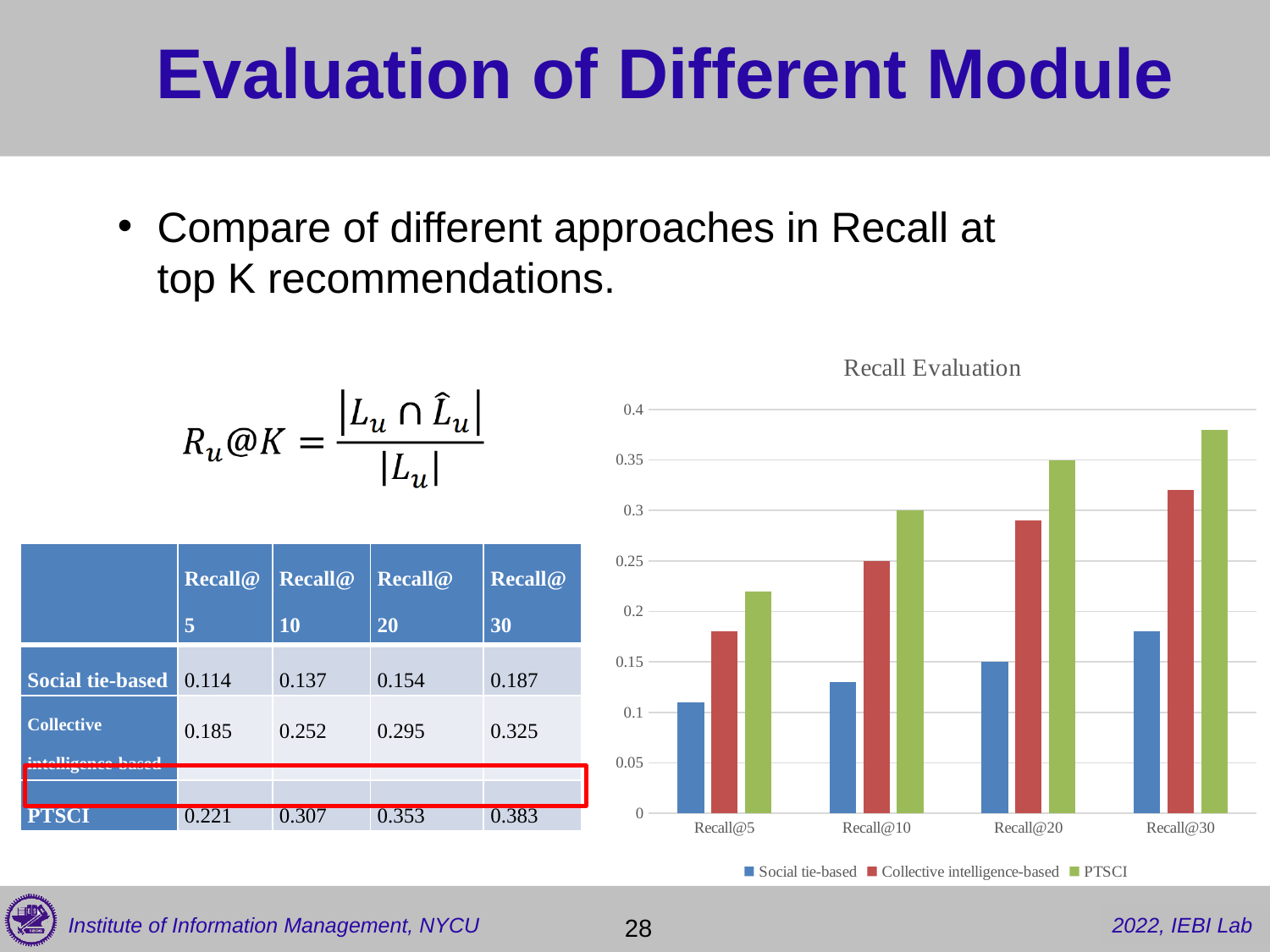
Is the value for Collective intelligence-based at Recall@30 greater or less than 0.3? greater What is the title of the chart? Recall Evaluation Which series has the highest bar in the chart? PTSCI Which series has the lowest bar in the chart? Social tie-based Is the value for Social tie-based at Recall@30 greater or less than 0.2? less What type of chart is shown on the slide? bar chart At Recall@20, which is larger: PTSCI or Social tie-based? PTSCI Do the values for PTSCI rise or fall from Recall@5 to Recall@30? rise Is the value for PTSCI at Recall@30 greater or less than 0.35? greater How many categories are shown on the x axis of the chart? 4 How many series does the chart legend list? 3